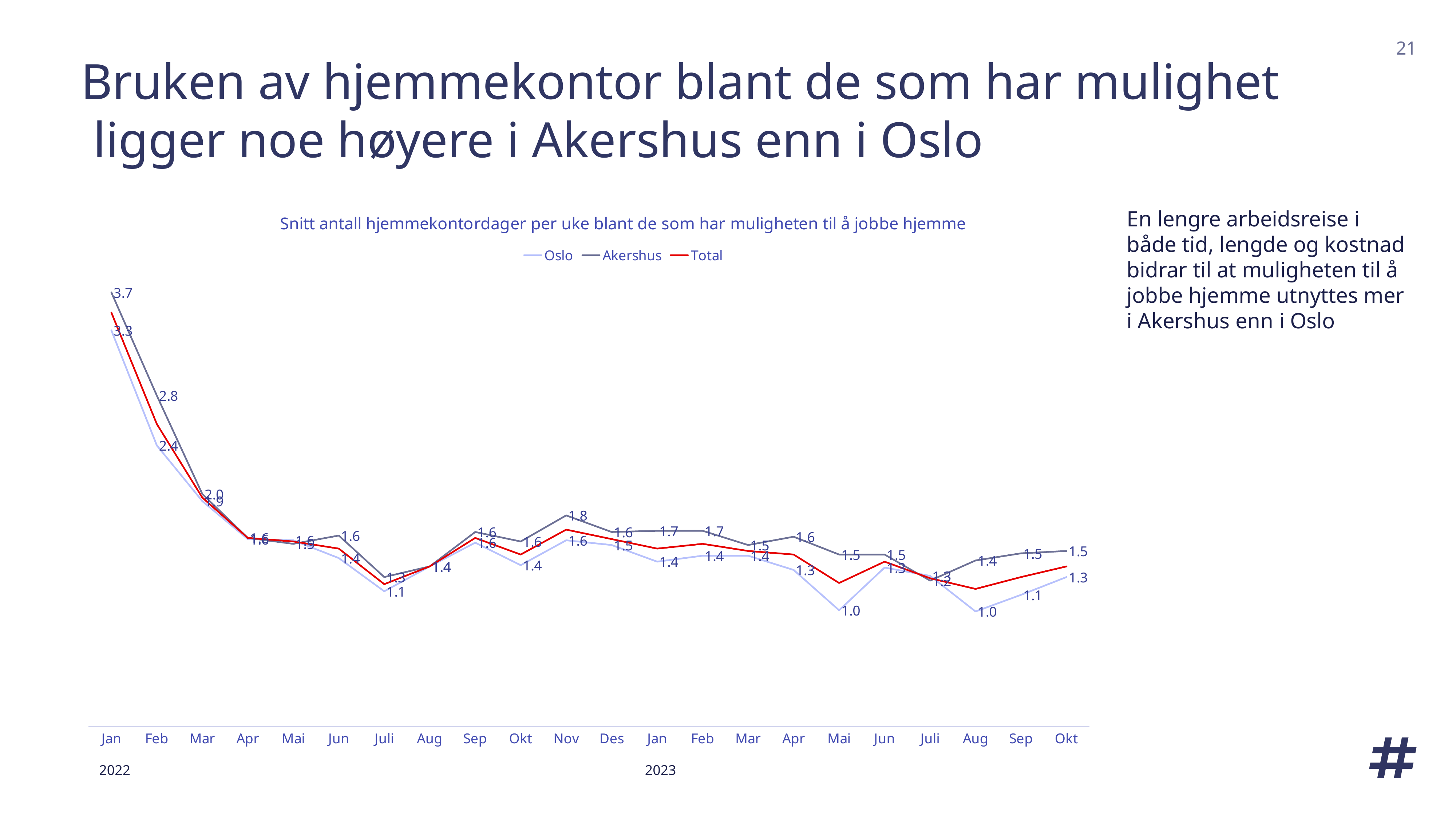
What is the difference between the Akershus and Oslo values in Jan 2022? 0.4 What is the value for Oslo in Jan 2022? 3.3 What is the difference between the Akershus and Oslo values in Okt 2023? 0.2 In which month does the Akershus series reach its highest value? Jan 2022 What is the value for Oslo in Mai 2023? 1.0 What is the value for Oslo in Okt 2023? 1.3 Which is larger in Nov 2022, the Oslo value or the Akershus value? Akershus How many series does the legend list? 3 What is the value for Akershus in Jan 2022? 3.7 Do the values rise or fall from Jan 2022 to Mar 2022? Fall What kind of chart is shown on the slide? Line chart What is the value for Akershus in Nov 2022? 1.8